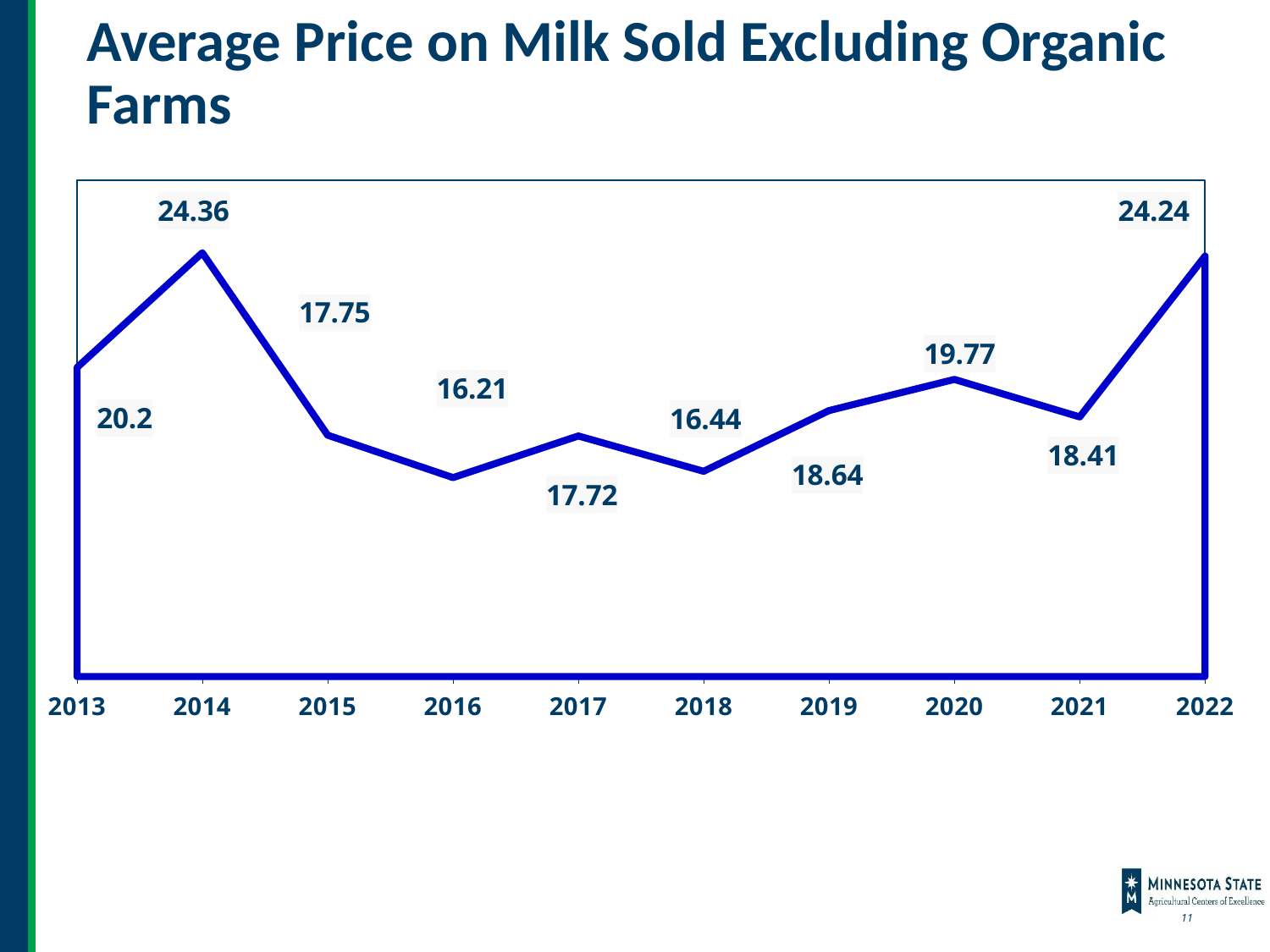
What was the average price on milk sold in 2020? 19.77 What was the average price on milk sold in 2016? 16.21 Which year had a higher average price on milk sold, 2019 or 2021? 2019 Which year has the highest average price on milk sold? 2014 What kind of chart is shown on the slide? Line chart How many years are plotted on the chart? 10 Did the average price on milk sold rise or fall from 2021 to 2022? Rise Which year has the lowest average price on milk sold? 2016 What is the difference between the average price in 2013 and in 2015? 2.45 What is the difference between the average price in 2014 and in 2022? 0.12 What was the average price on milk sold in 2013? 20.2 What was the average price on milk sold in 2014? 24.36